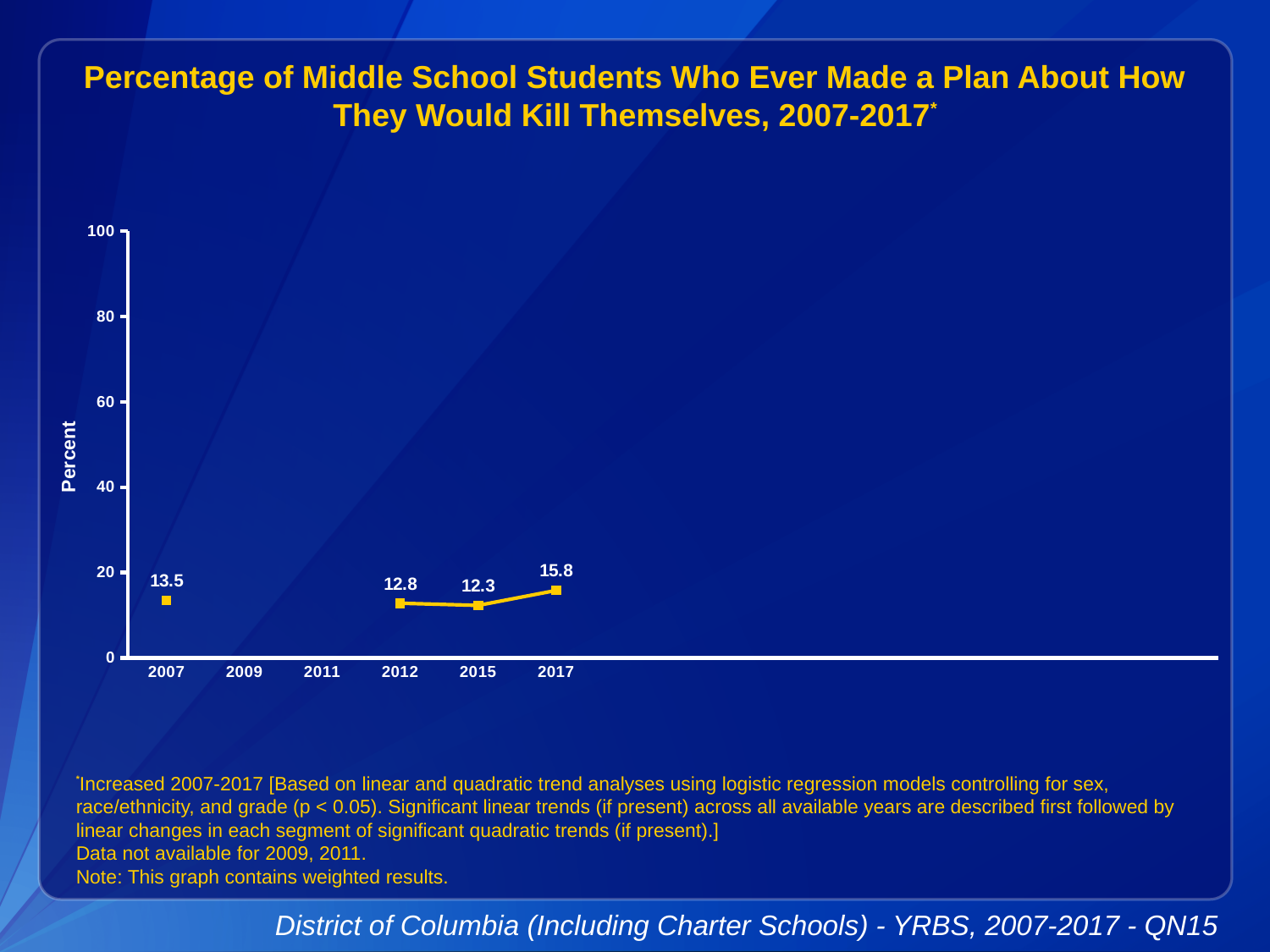
Which year has the highest value? 2017 What is the difference between the values for 2017 and 2015? 3.5 Which year has the lowest value? 2015 What is the value for 2015? 12.3 How many years have a plotted data point? 4 Is the value for 2017 greater or less than 20? less What is the value for 2007? 13.5 What is the value for 2017? 15.8 What is the value for 2012? 12.8 Which is larger, the value for 2007 or the value for 2012? 2007 What kind of chart is this? line chart What is the label on the y axis? Percent